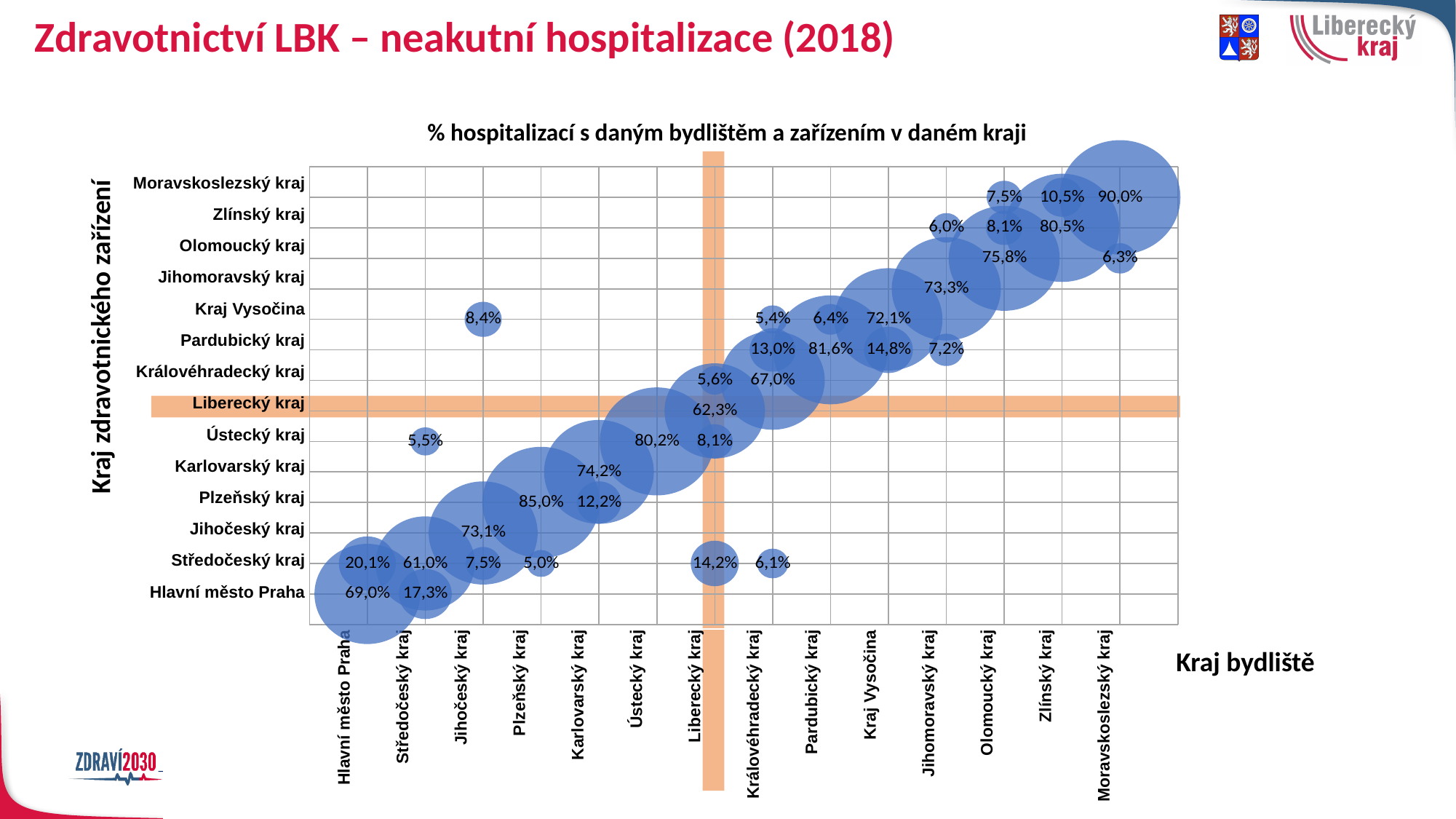
What is the label of the horizontal axis? Kraj bydliště What percentage is shown for residents of Liberecký kraj hospitalised in facilities in Středočeský kraj? 14,2% How many regions are listed along the horizontal axis? 14 What percentage is shown for residents of Liberecký kraj hospitalised in facilities in Liberecký kraj? 62,3% What is the difference between the percentage for Plzeňský kraj residents in Plzeňský kraj facilities (85,0%) and Liberecký kraj residents in Liberecký kraj facilities (62,3%)? 22,7% Which is larger: the percentage for Pardubický kraj residents in Pardubický kraj facilities or for Královéhradecký kraj residents in Královéhradecký kraj facilities? Pardubický kraj (81,6%) Which data label on the chart shows the lowest percentage? 5,0% Which data label on the chart shows the highest percentage? 90,0% What percentage is shown for residents of Moravskoslezský kraj hospitalised in facilities in Moravskoslezský kraj? 90,0% What is the title of the chart? % hospitalizací s daným bydlištěm a zařízením v daném kraji What type of chart is shown on the slide? bubble chart What percentage is shown for residents of Středočeský kraj hospitalised in facilities in Hlavní město Praha? 17,3%